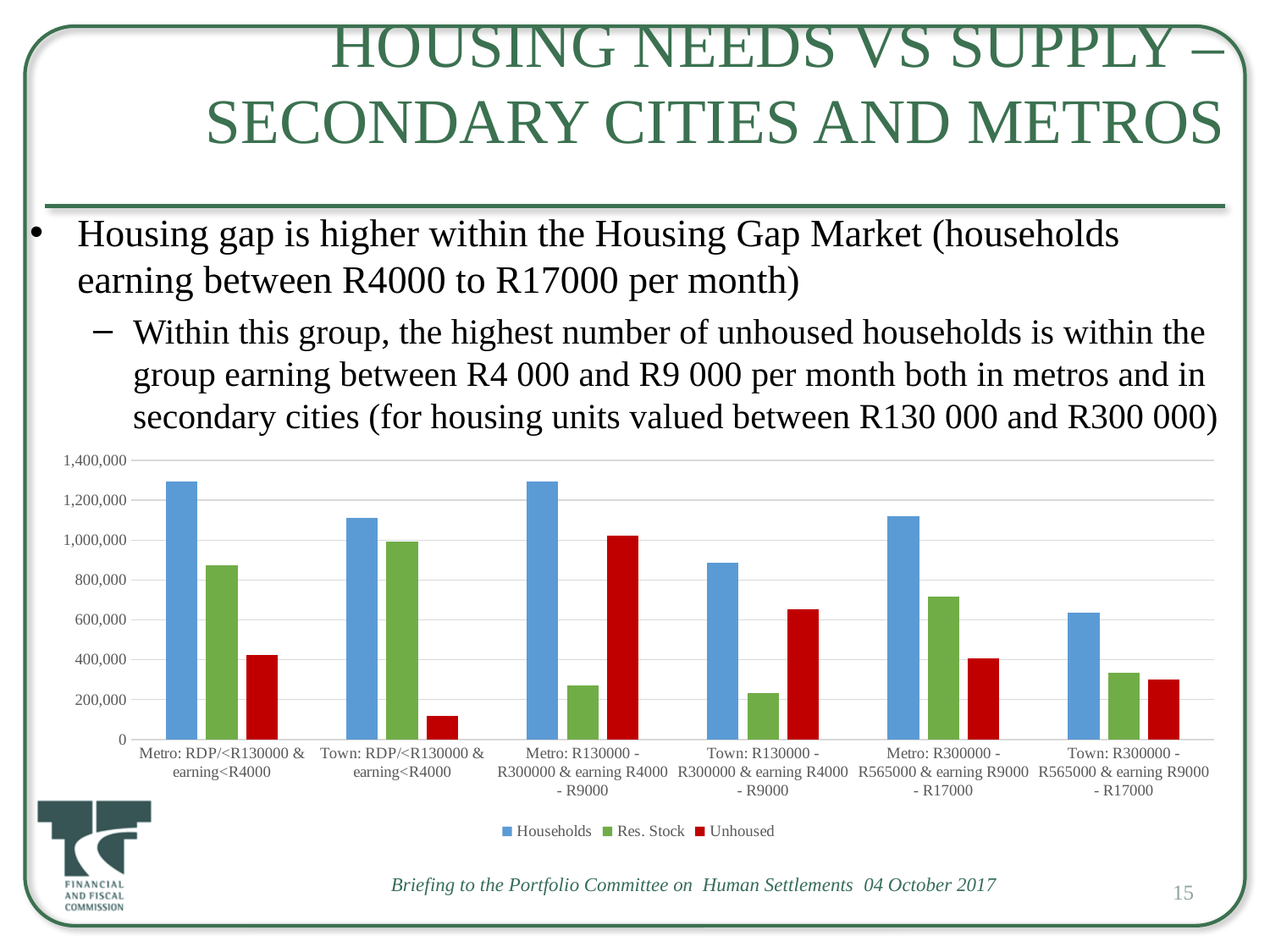
Which is larger for Town: RDP/<R130000 & earning<R4000: Res. Stock or Unhoused? Res. Stock What kind of chart is shown on the slide? bar chart Which category has the lowest Unhoused value? Town: RDP/<R130000 & earning<R4000 Is the Res. Stock value for Metro: R130000 - R300000 & earning R4000 - R9000 greater or less than 400,000? less Which category has the lowest Households value? Town: R300000 - R565000 & earning R9000 - R17000 Which category has the highest Unhoused value? Metro: R130000 - R300000 & earning R4000 - R9000 How many categories are shown along the x axis of the chart? 6 Is the Households value for Town: R300000 - R565000 & earning R9000 - R17000 greater or less than 800,000? less Which colour represents the Unhoused series in the chart? red Which category has the highest Res. Stock value? Town: RDP/<R130000 & earning<R4000 How many series does the chart legend list? 3 Is the Unhoused value for Metro: R130000 - R300000 & earning R4000 - R9000 greater or less than 800,000? greater